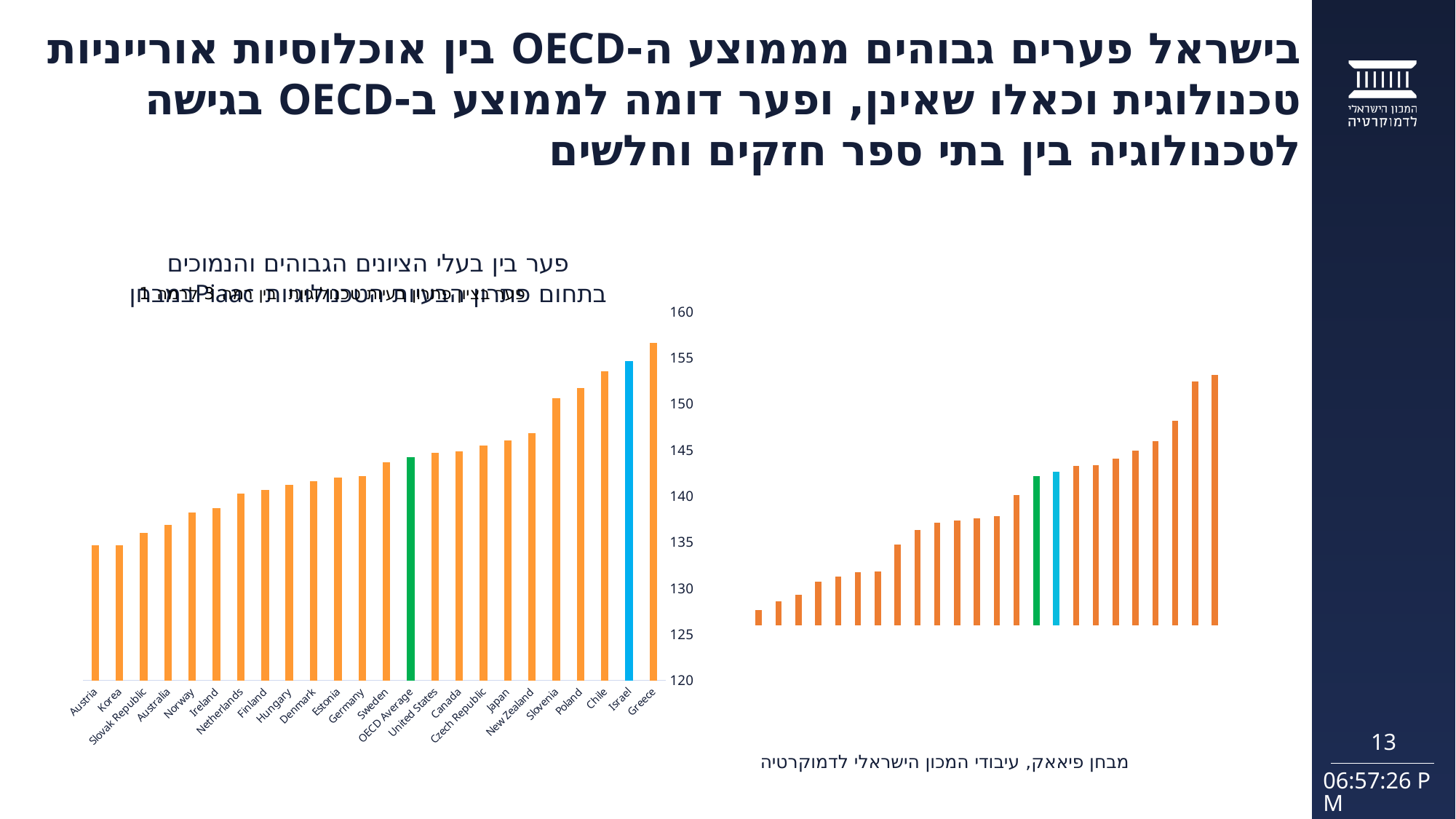
What kind of chart is the left chart on the slide? bar chart In the left chart, which country has the highest value? Greece In the left chart, is the value for OECD Average greater or less than 140? greater In the left chart, which is larger, the value for Greece or the value for Chile? Greece In the left chart, is the value for Germany greater or less than 145? less In the left chart, is the value for Israel greater or less than 150? greater In the left chart, what colour is the bar for Israel? blue In the left chart, do the values rise or fall from left to right along the x axis? rise What kind of chart is the right chart on the slide? bar chart In the left chart, how many categories are shown on the x axis? 24 In the left chart, which is larger, the value for Sweden or the value for Norway? Sweden